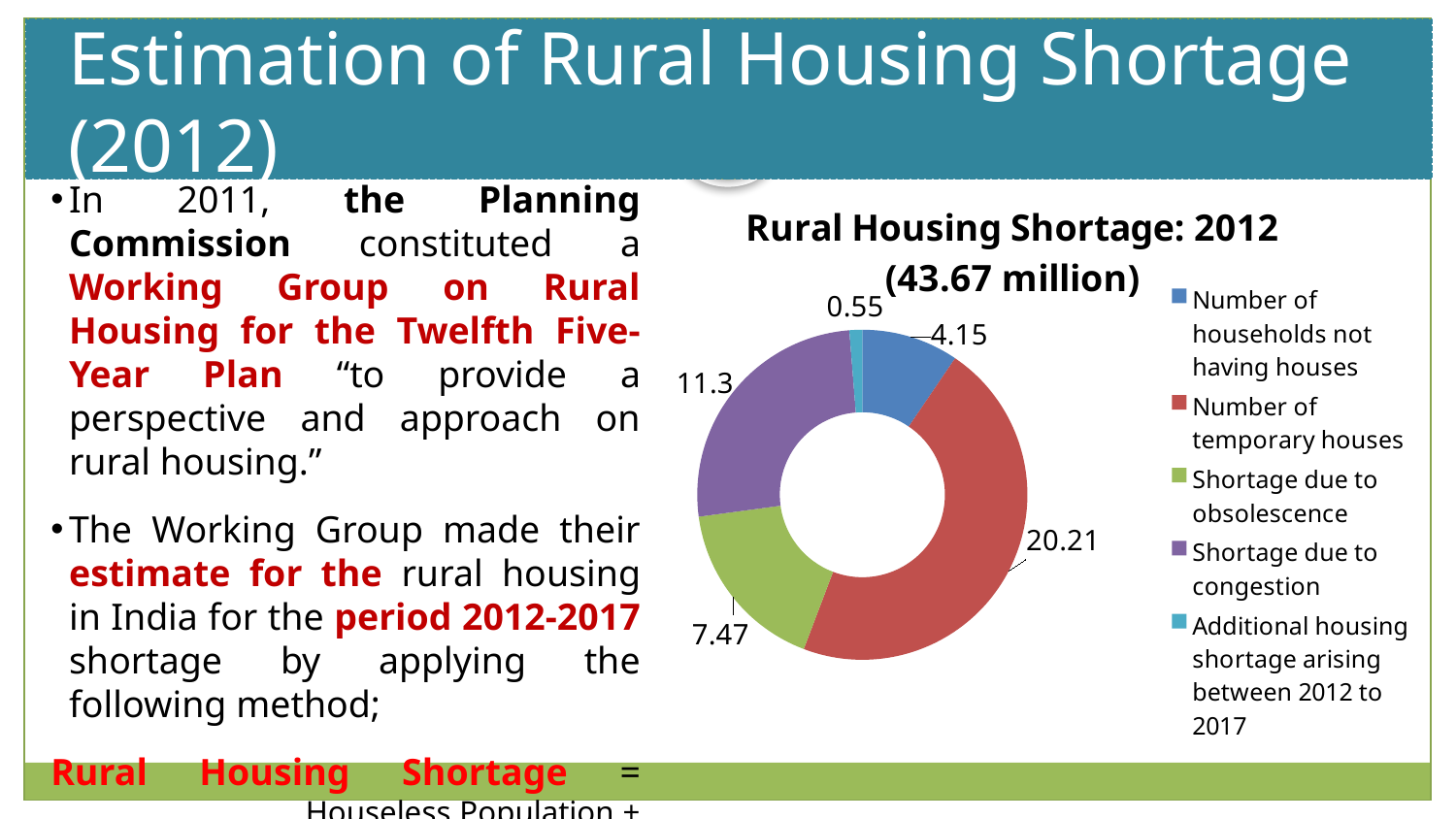
What is the value for Shortage due to obsolescence in the Rural Housing Shortage: 2012 chart? 7.47 How many categories are shown in the Rural Housing Shortage: 2012 chart? 5 Which is larger in the Rural Housing Shortage: 2012 chart, Shortage due to obsolescence or Number of households not having houses? Shortage due to obsolescence What is the value for Number of households not having houses in the Rural Housing Shortage: 2012 chart? 4.15 What is the value for Additional housing shortage arising between 2012 to 2017 in the Rural Housing Shortage: 2012 chart? 0.55 Which category has the largest value in the Rural Housing Shortage: 2012 chart? Number of temporary houses What kind of chart is the Rural Housing Shortage: 2012 chart? Doughnut (pie) chart What is the value for Shortage due to congestion in the Rural Housing Shortage: 2012 chart? 11.3 Which category has the smallest value in the Rural Housing Shortage: 2012 chart? Additional housing shortage arising between 2012 to 2017 What is the difference between the values for Number of temporary houses and Shortage due to congestion in the Rural Housing Shortage: 2012 chart? 8.91 What is the value for Number of temporary houses in the Rural Housing Shortage: 2012 chart? 20.21 What total is given in the title of the Rural Housing Shortage: 2012 chart? 43.67 million